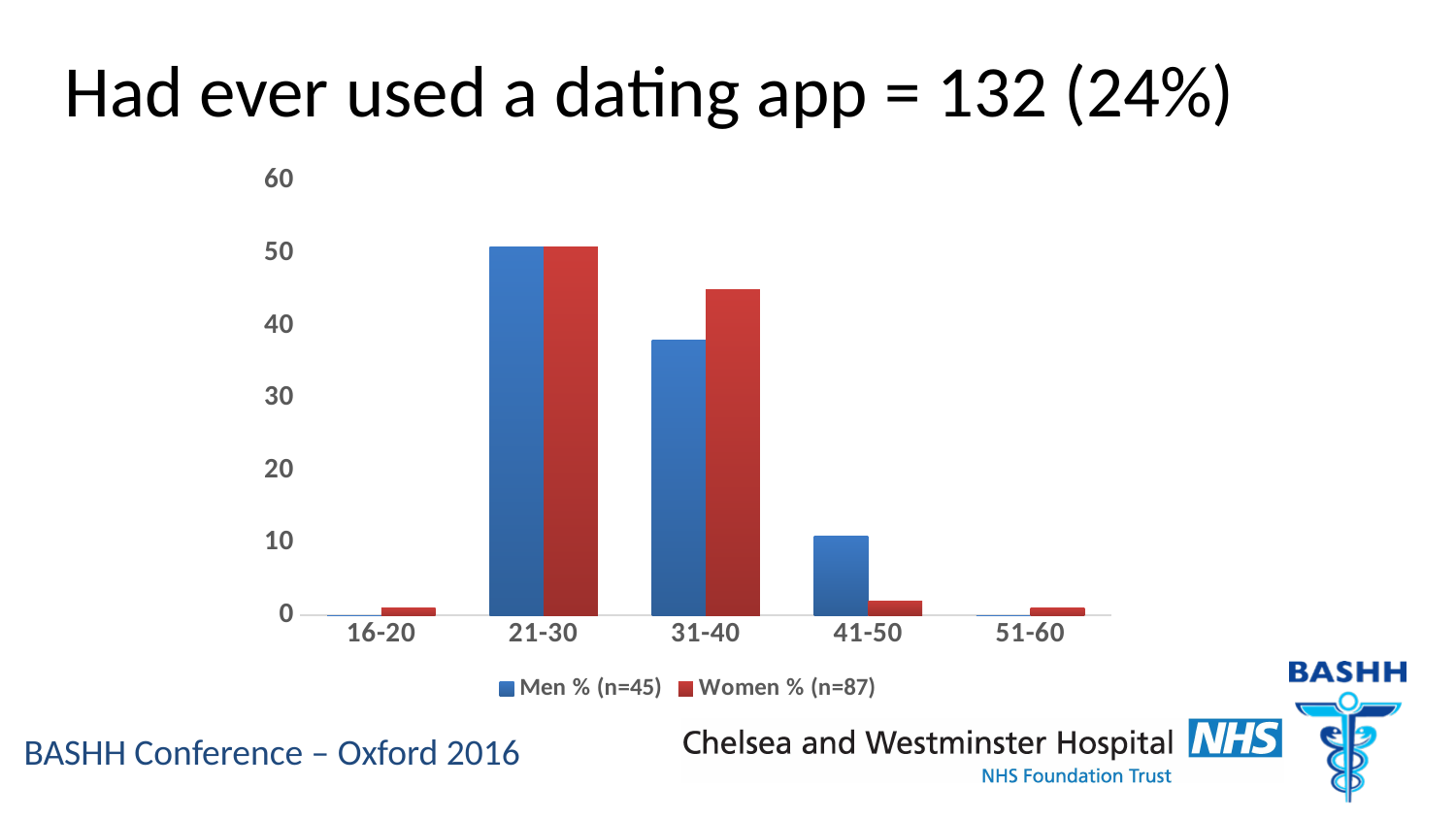
In the 41-50 age group, which series has the larger value, Men % (n=45) or Women % (n=87)? Men % (n=45) Which age group has the highest value for Women % (n=87)? 21-30 What kind of chart is shown on the slide? bar chart Is the value for Men % (n=45) in the 21-30 age group greater or less than 40? greater What are the two legend entries of the chart? Men % (n=45) and Women % (n=87) How many series does the chart's legend list? 2 From the 21-30 age group to the 51-60 age group, do the Men % (n=45) values rise or fall? fall Is the value for Men % (n=45) in the 41-50 age group greater or less than 20? less In the 31-40 age group, which series has the larger value, Men % (n=45) or Women % (n=87)? Women % (n=87) Which age group has the highest value for Men % (n=45)? 21-30 Is the value for Women % (n=87) in the 31-40 age group greater or less than 40? greater How many age groups are shown on the x axis of the chart? 5